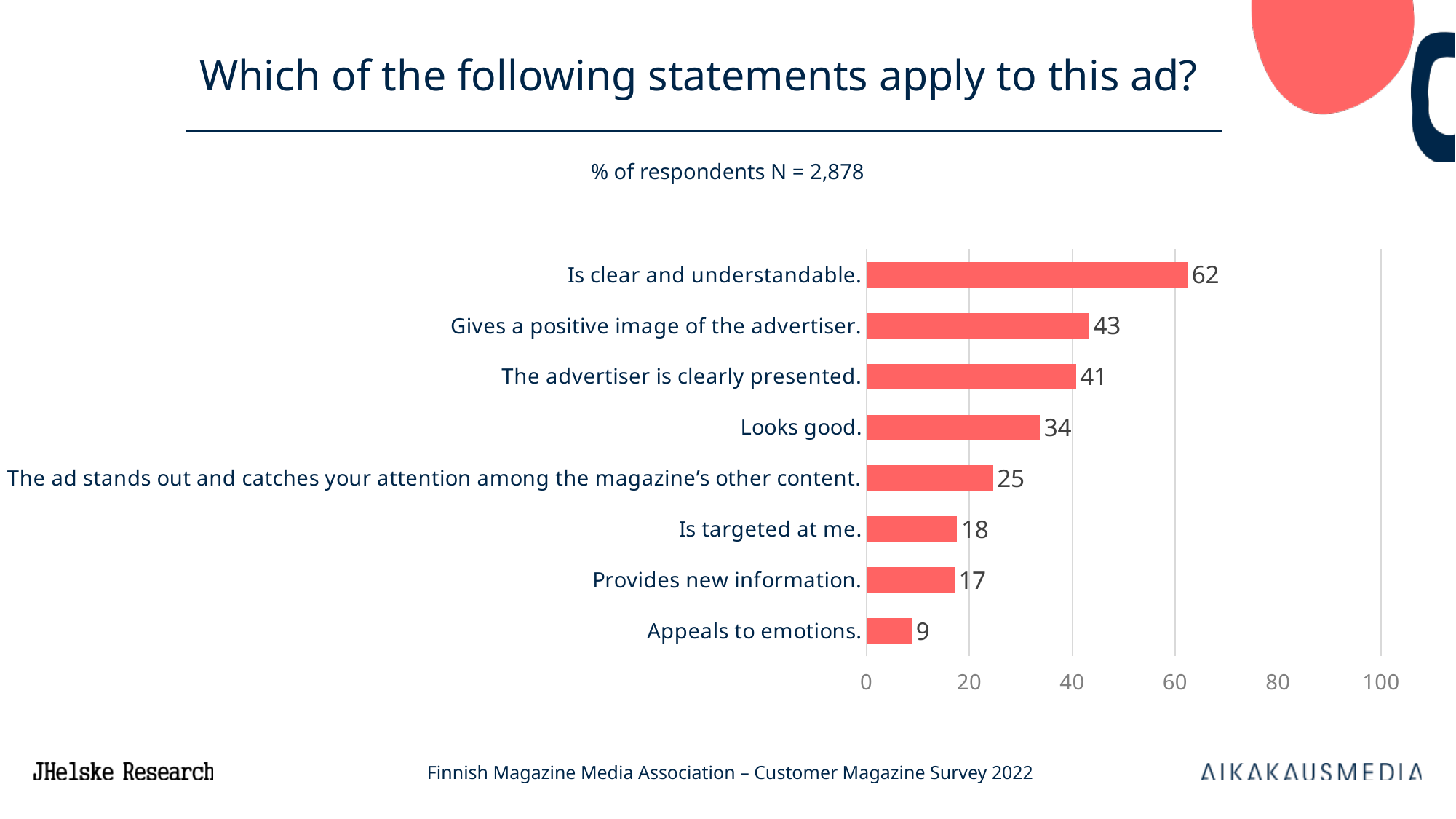
How many statements are shown in the chart? 8 What value is shown for "Looks good."? 34 What is the number of respondents (N) stated on the slide? 2,878 Which is larger: the value for "Is targeted at me." or the value for "The ad stands out and catches your attention among the magazine's other content."? The ad stands out and catches your attention among the magazine's other content. What percentage of respondents said the ad is clear and understandable? 62 What is the difference between "Looks good." and "Appeals to emotions."? 25 What percentage of respondents said the ad provides new information? 17 Which statement has the highest value? Is clear and understandable. What kind of chart is shown on the slide? Bar chart Is the value for "The advertiser is clearly presented." greater or less than 40? greater Which statement has the lowest value? Appeals to emotions. What is the difference between "Is clear and understandable." and "Gives a positive image of the advertiser."? 19